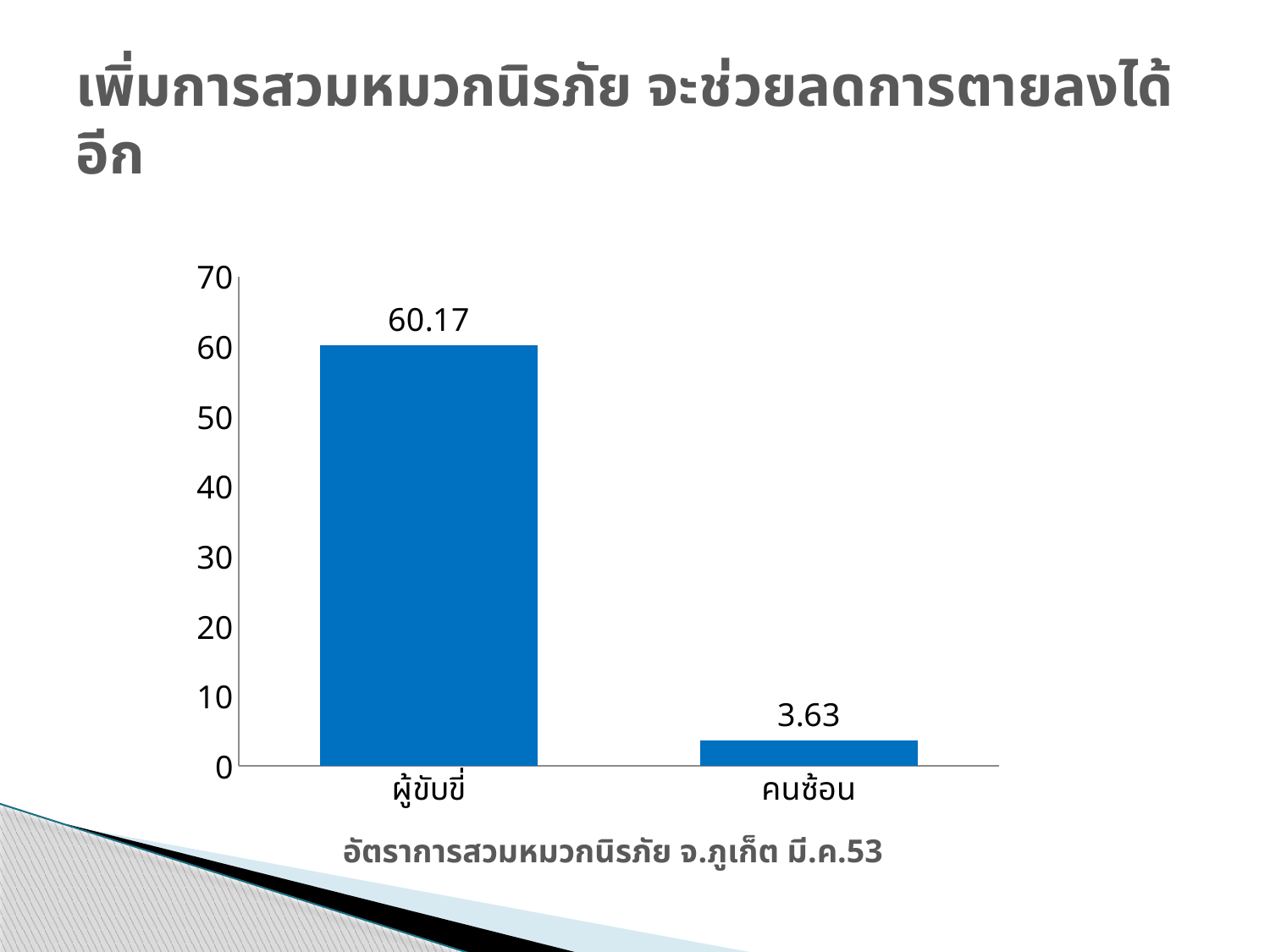
What is the value for ผู้ขับขี่? 60.17 Which category has the lowest value? คนซ้อน Which category has the highest value? ผู้ขับขี่ What is the highest value shown on the y axis? 70 What is the value for คนซ้อน? 3.63 What is the caption printed below the chart? อัตราการสวมหมวกนิรภัย จ.ภูเก็ต มี.ค.53 What is the difference between the values for ผู้ขับขี่ and คนซ้อน? 56.54 How many categories are shown on the x axis? 2 Is the value for คนซ้อน greater or less than 10? less What kind of chart is shown on the slide? bar chart Which is larger, the value for ผู้ขับขี่ or the value for คนซ้อน? ผู้ขับขี่ Is the value for ผู้ขับขี่ greater or less than 50? greater